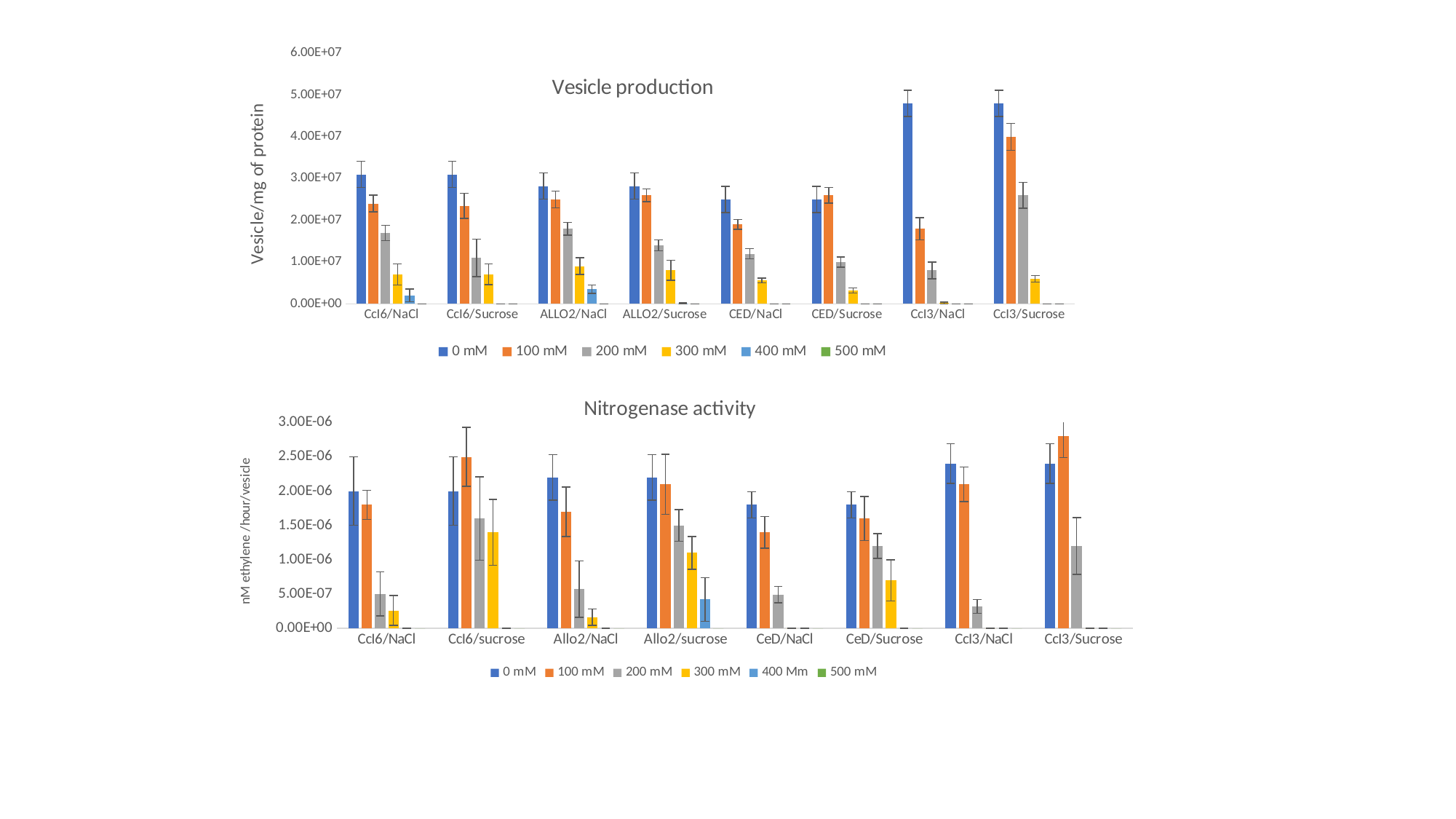
In the "Vesicle production" chart, which category has the highest 100 mM value? Ccl3/Sucrose In the "Vesicle production" chart, is the 200 mM value for Ccl6/NaCl greater or less than 1.00E+07? greater In the "Nitrogenase activity" chart, which category has the highest 100 mM value? Ccl3/Sucrose What is the y-axis title of the "Nitrogenase activity" chart? nM ethylene /hour/vesicle What kind of chart is the "Vesicle production" chart? bar chart In the "Vesicle production" chart, is the 300 mM value for CED/Sucrose greater or less than 1.00E+07? less In the "Vesicle production" chart, which is larger: the 100 mM value for Ccl3/NaCl or the 100 mM value for Ccl3/Sucrose? Ccl3/Sucrose In the "Vesicle production" chart, is the 0 mM value for Ccl3/NaCl greater or less than 4.00E+07? greater How many series does the legend of the "Vesicle production" chart list? 6 How many categories are shown on the x axis of the "Nitrogenase activity" chart? 8